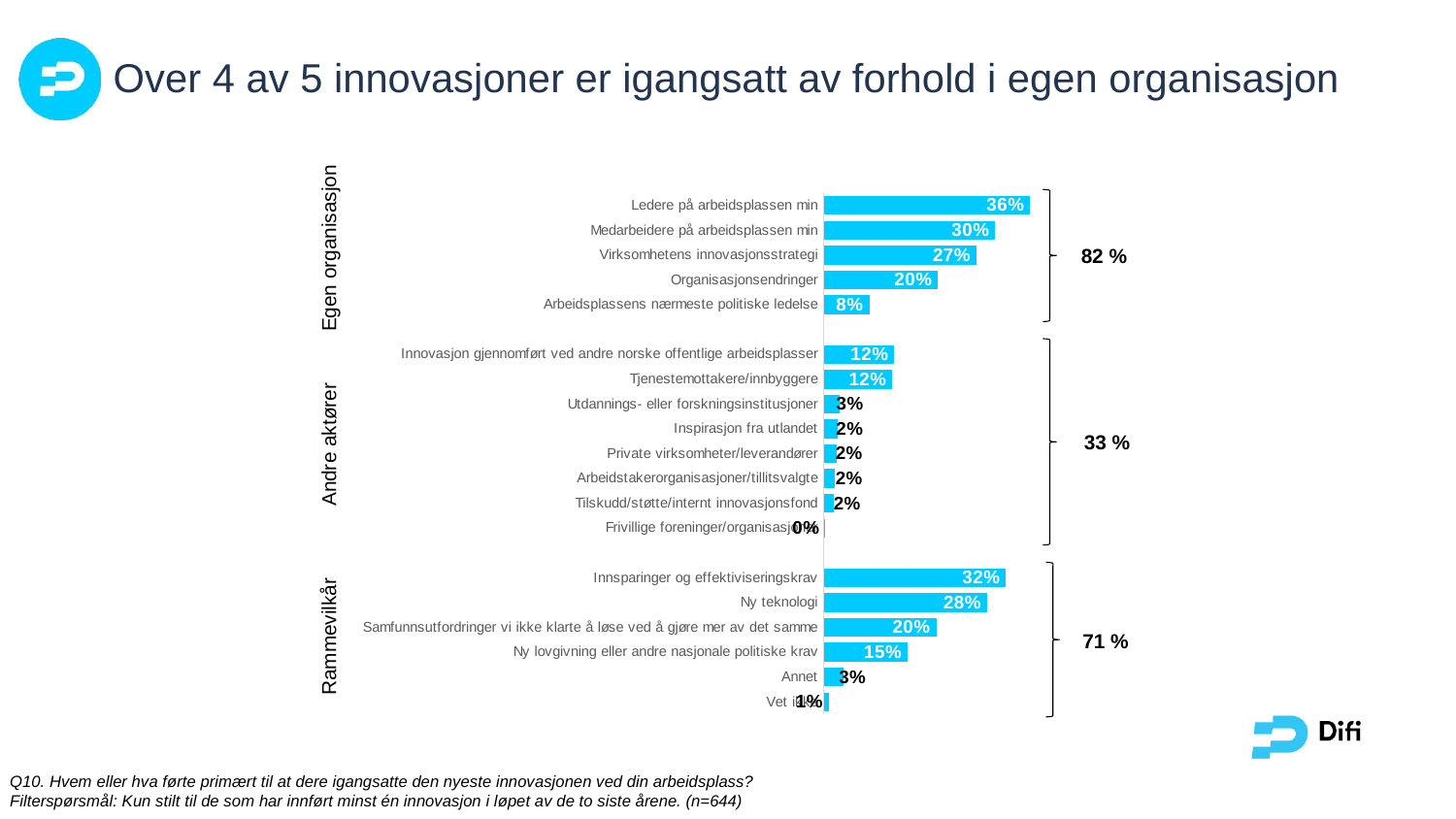
What percentage is shown for the "Andre aktører" group as a whole? 33 % What is the value for "Ny teknologi"? 28% What is the value for "Arbeidsplassens nærmeste politiske ledelse"? 8% How many categories are plotted in the chart? 19 What is the value for "Tjenestemottakere/innbyggere"? 12% What is the value for "Ledere på arbeidsplassen min"? 36% Which category has the highest value in the chart? Ledere på arbeidsplassen min What kind of chart is shown on the slide? Bar chart Which is larger, the value for "Medarbeidere på arbeidsplassen min" or the value for "Virksomhetens innovasjonsstrategi"? Medarbeidere på arbeidsplassen min What is the difference between the values for "Innsparinger og effektiviseringskrav" and "Ny lovgivning eller andre nasjonale politiske krav"? 17% Which category has the lowest value in the chart? Frivillige foreninger/organisasjoner What percentage is shown for the "Egen organisasjon" group as a whole? 82 %